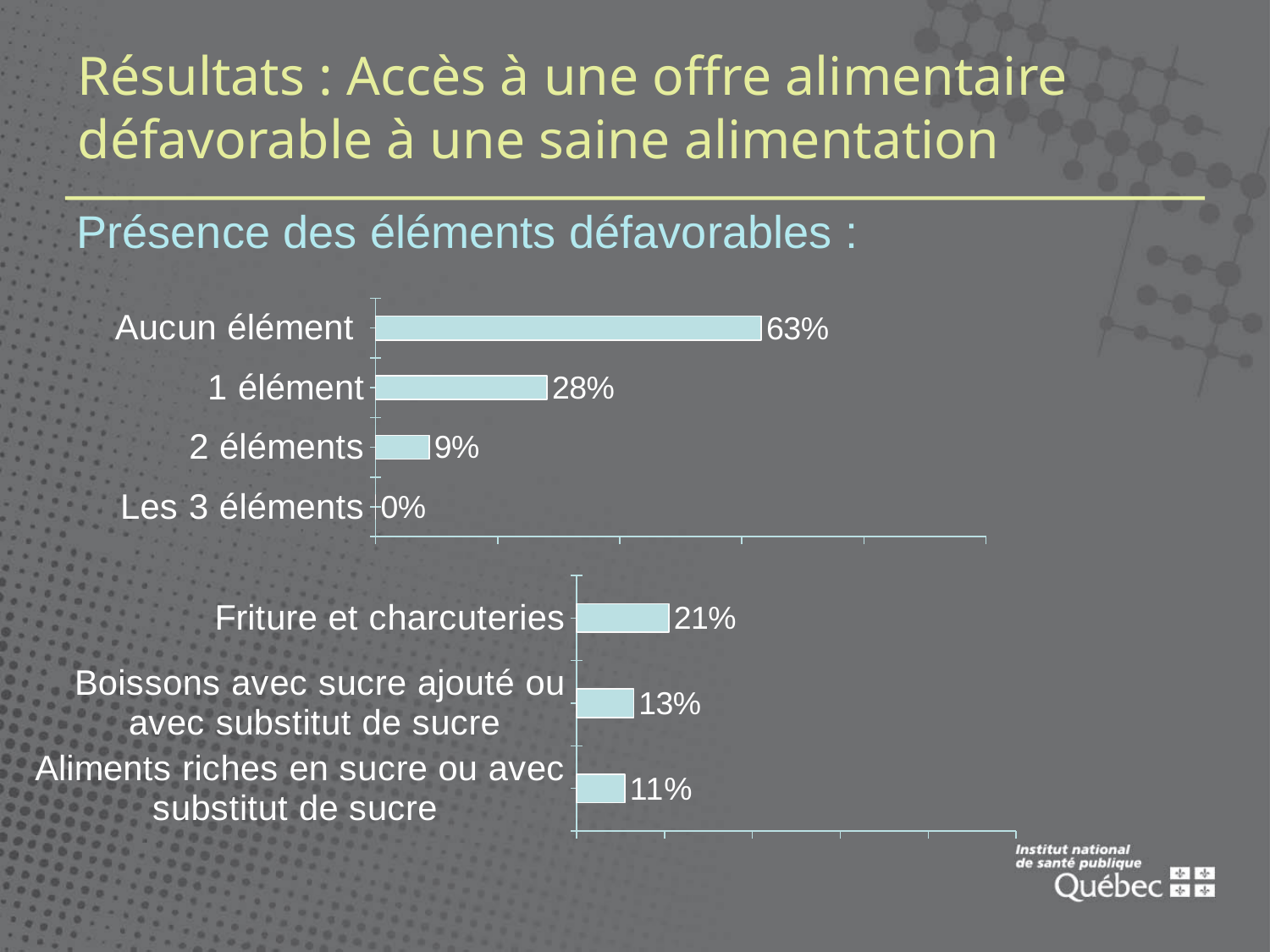
In the bottom chart, which category has the lowest value? Aliments riches en sucre ou avec substitut de sucre In the top chart, what is the value for "Les 3 éléments"? 0% In the bottom chart, which is larger: "Boissons avec sucre ajouté ou avec substitut de sucre" or "Aliments riches en sucre ou avec substitut de sucre"? Boissons avec sucre ajouté ou avec substitut de sucre In the top chart, what is the value for "2 éléments"? 9% In the top chart, which category has the highest value? Aucun élément How many categories does the top chart show? 4 In the top chart, what is the value for "Aucun élément"? 63% In the bottom chart, what is the difference between "Friture et charcuteries" and "Boissons avec sucre ajouté ou avec substitut de sucre"? 8% In the bottom chart, what is the value for "Aliments riches en sucre ou avec substitut de sucre"? 11% What kind of chart is the bottom chart? Bar chart In the top chart, what is the difference between the values for "Aucun élément" and "1 élément"? 35% In the bottom chart, what is the value for "Friture et charcuteries"? 21%